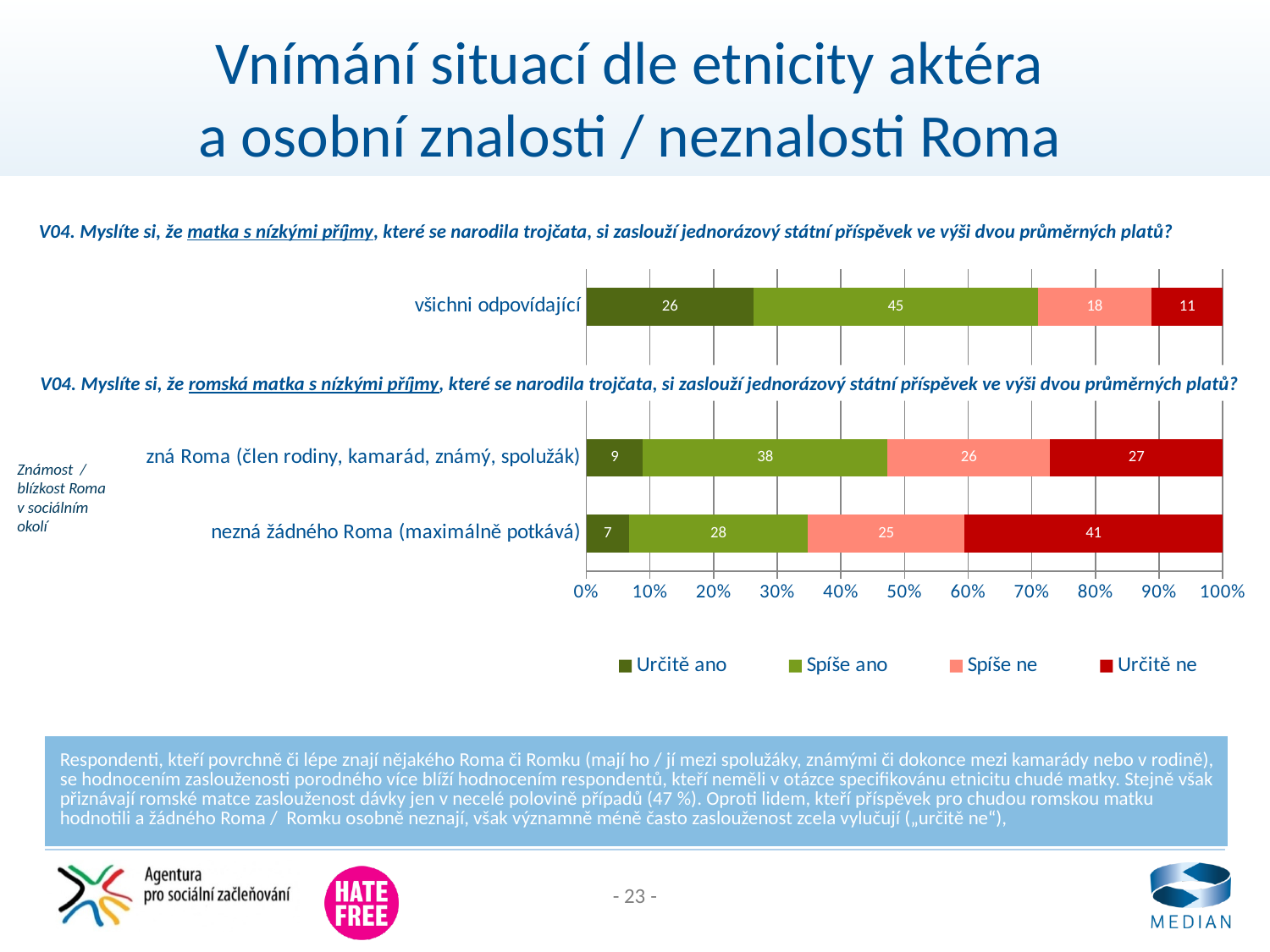
What type of chart is used on this slide? Stacked bar chart In the bottom chart (romská matka s nízkými příjmy), what is the combined 'Určitě ano' and 'Spíše ano' total for 'zná Roma'? 47 In the top chart (matka s nízkými příjmy), what is the value of 'Spíše ano' for 'všichni odpovídající'? 45 How many series does the legend list? 4 In the top chart (matka s nízkými příjmy), which segment of the 'všichni odpovídající' bar is the largest? Spíše ano How many categories (bars) are shown in the bottom chart (romská matka s nízkými příjmy)? 2 In the bottom chart (romská matka s nízkými příjmy), is the 'Spíše ano' value larger for 'zná Roma' or for 'nezná žádného Roma'? zná Roma In the bottom chart (romská matka s nízkými příjmy), what is the 'Spíše ano' value for 'zná Roma (člen rodiny, kamarád, známý, spolužák)'? 38 In the bottom chart (romská matka s nízkými příjmy), which category has the higher 'Určitě ne' value? nezná žádného Roma (maximálně potkává) In the top chart (matka s nízkými příjmy), what is the value of 'Určitě ne' for 'všichni odpovídající'? 11 In the bottom chart (romská matka s nízkými příjmy), what is the 'Určitě ne' value for 'nezná žádného Roma (maximálně potkává)'? 41 In the bottom chart (romská matka s nízkými příjmy), what is the difference between the 'Určitě ne' values for 'nezná žádného Roma' and 'zná Roma'? 14